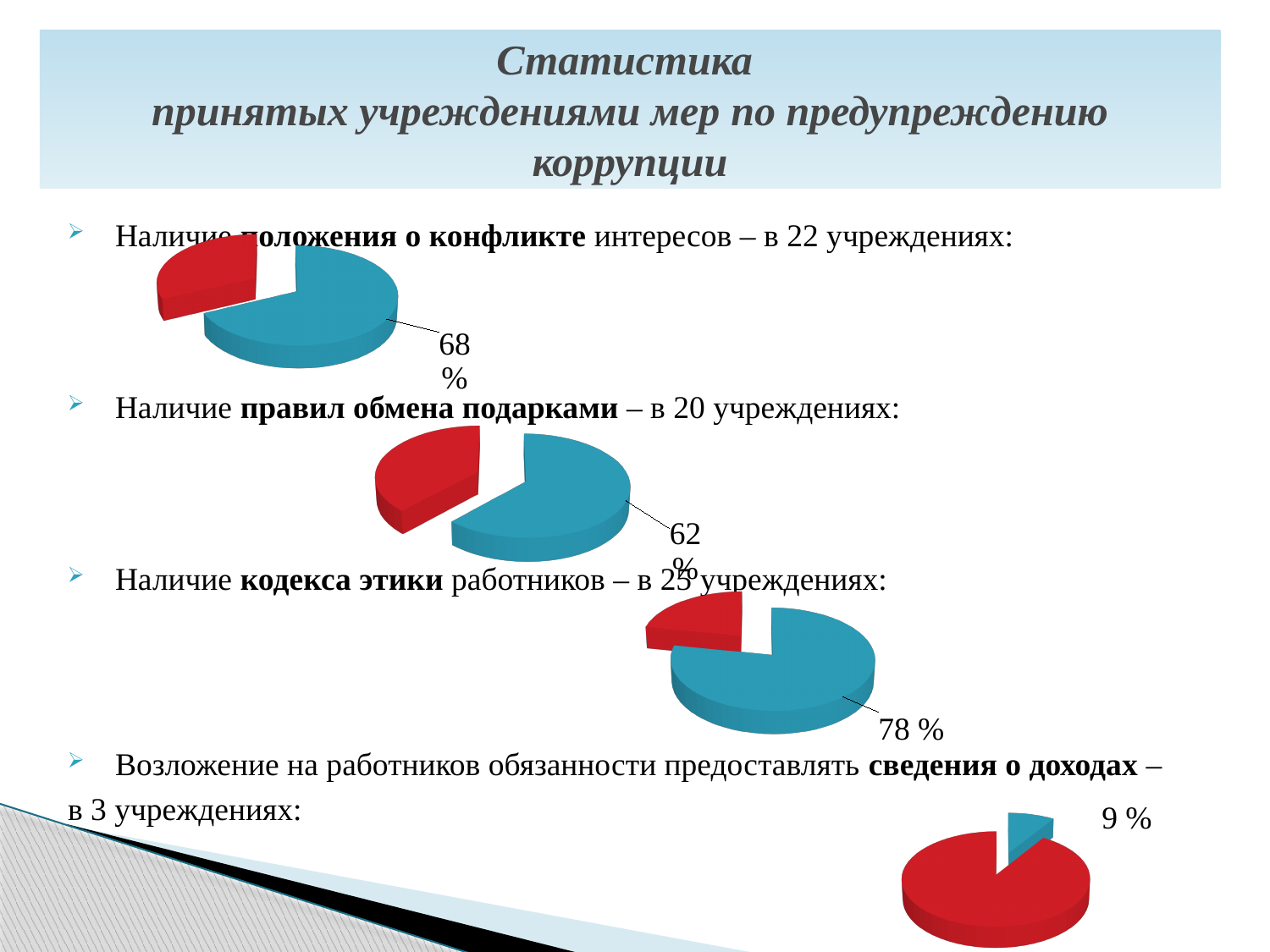
In the third pie chart (next to the bullet about the code of ethics), what value is labelled on the blue slice? 78 % In the bottom pie chart (next to the bullet about income information), what value is labelled on the small blue slice? 9 % Among the four pie charts, which one has the largest labelled value? The third pie chart (code of ethics), 78 % What type of chart is used for each of the four charts on the slide? Pie chart How many pie charts are shown on the slide? 4 How many slices does the top pie chart have? 2 Among the four pie charts, which one has the smallest labelled value? The bottom pie chart (income information), 9 % In the second pie chart (next to the bullet about gift exchange rules), what value is labelled on the blue slice? 62 % What is the difference between the labelled value in the third pie chart (78 %) and the labelled value in the second pie chart (62 %)? 16 % In the bottom pie chart, which colour is the larger slice? Red In the top pie chart (next to the bullet about the conflict of interest provision), what value is shown for the blue slice? 68 % Which is larger: the labelled value in the third pie chart (code of ethics) or the labelled value in the top pie chart (conflict of interest provision)? The third pie chart (78 %)